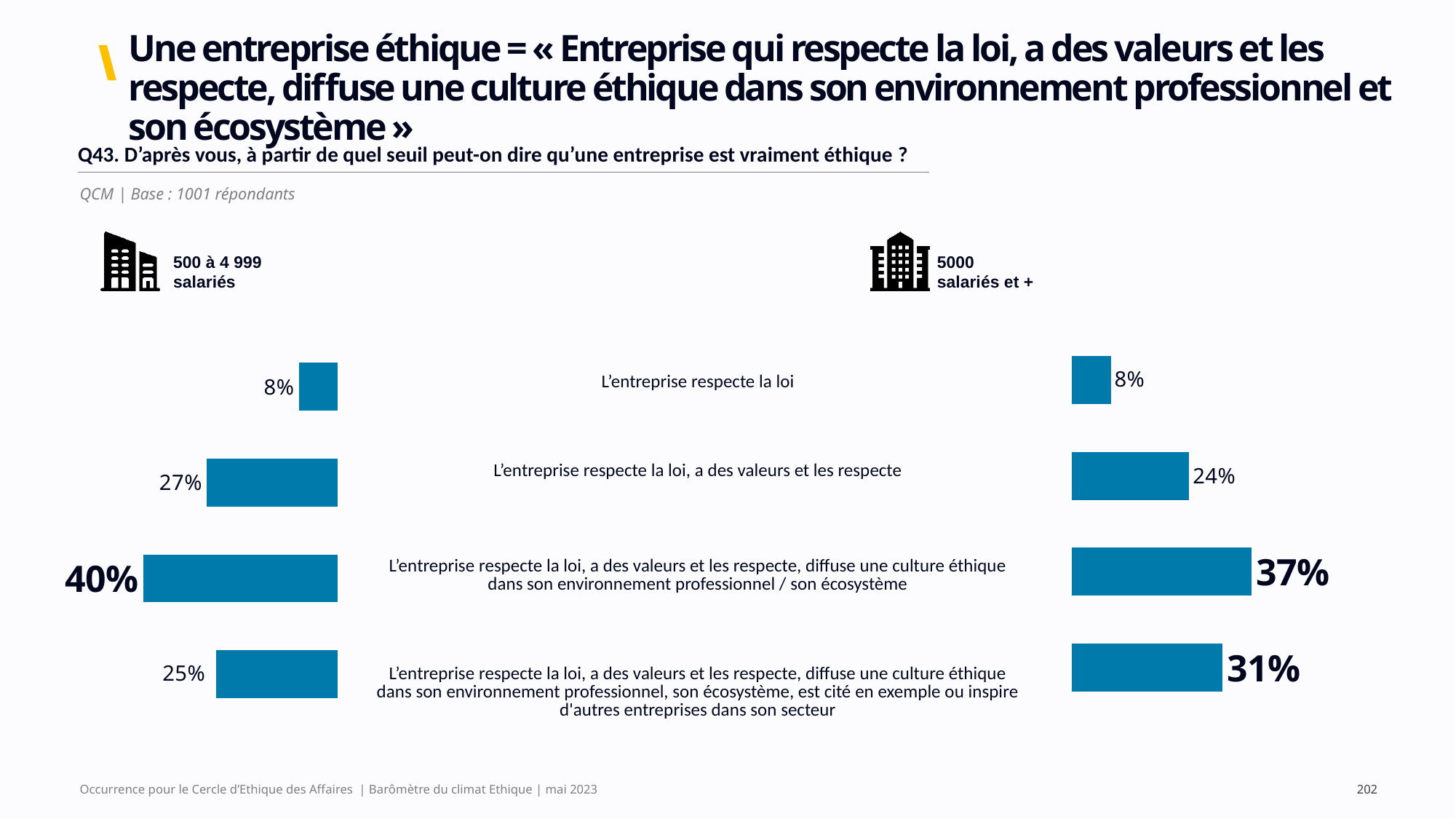
What type of chart is used on this slide? Bar chart In the chart for 5000 salariés et +, which answer option has the lowest value? L'entreprise respecte la loi Which is larger: the value for the longest answer option in the 500 à 4 999 salariés chart or in the 5000 salariés et + chart? 5000 salariés et + How many answer options are plotted in the chart for 500 à 4 999 salariés? 4 What is the difference between the highest value in the 500 à 4 999 salariés chart and the highest value in the 5000 salariés et + chart? 3 points What is the base (number of respondents) stated for the charts on this slide? 1001 répondants In the chart for 5000 salariés et +, what percentage chose « L'entreprise respecte la loi, a des valeurs et les respecte » ? 24% In the chart for 500 à 4 999 salariés, which answer option has the highest value? L'entreprise respecte la loi, a des valeurs et les respecte, diffuse une culture éthique dans son environnement professionnel / son écosystème In the chart for 5000 salariés et +, what is the value for « L'entreprise respecte la loi »? 8% In the chart for 500 à 4 999 salariés, what is the difference between the value for « diffuse une culture éthique dans son environnement professionnel / son écosystème » and the value for « L'entreprise respecte la loi »? 32 points In the chart for 5000 salariés et +, what is the value for the longest answer option (cité en exemple ou inspire d'autres entreprises dans son secteur)? 31% In the chart for 500 à 4 999 salariés, what percentage chose « L'entreprise respecte la loi, a des valeurs et les respecte » ? 27%